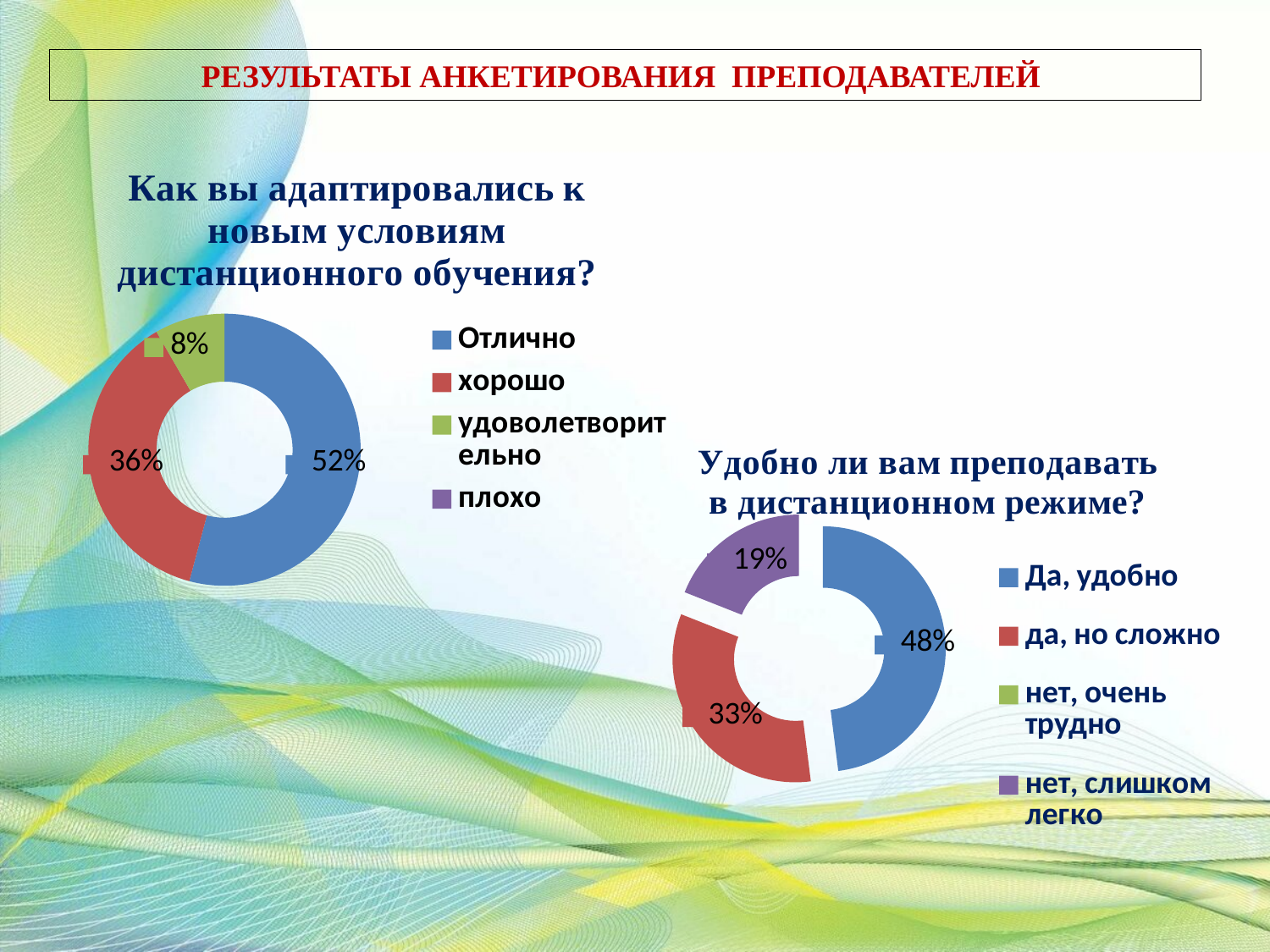
In the chart titled "Как вы адаптировались к новым условиям дистанционного обучения?", what percentage is shown for "хорошо"? 36% In the chart titled "Удобно ли вам преподавать в дистанционном режиме?", which is larger: "да, но сложно" or "нет, слишком легко"? да, но сложно In the chart titled "Как вы адаптировались к новым условиям дистанционного обучения?", which category has the largest share? Отлично In the chart titled "Как вы адаптировались к новым условиям дистанционного обучения?", what is the difference in percentage points between "Отлично" and "хорошо"? 16 In the chart titled "Как вы адаптировались к новым условиям дистанционного обучения?", what percentage is shown for "удоволетворительно"? 8% What type of chart is used for the chart titled "Удобно ли вам преподавать в дистанционном режиме?"? doughnut chart In the chart titled "Удобно ли вам преподавать в дистанционном режиме?", what percentage is shown for "Да, удобно"? 48% In the chart titled "Как вы адаптировались к новым условиям дистанционного обучения?", how many entries does the legend list? 4 In the chart titled "Удобно ли вам преподавать в дистанционном режиме?", what is the difference in percentage points between "Да, удобно" and "да, но сложно"? 15 In the chart titled "Как вы адаптировались к новым условиям дистанционного обучения?", what percentage is shown for "Отлично"? 52% In the chart titled "Удобно ли вам преподавать в дистанционном режиме?", what percentage is shown for "да, но сложно"? 33% In the chart titled "Удобно ли вам преподавать в дистанционном режиме?", what percentage is shown for "нет, слишком легко"? 19%